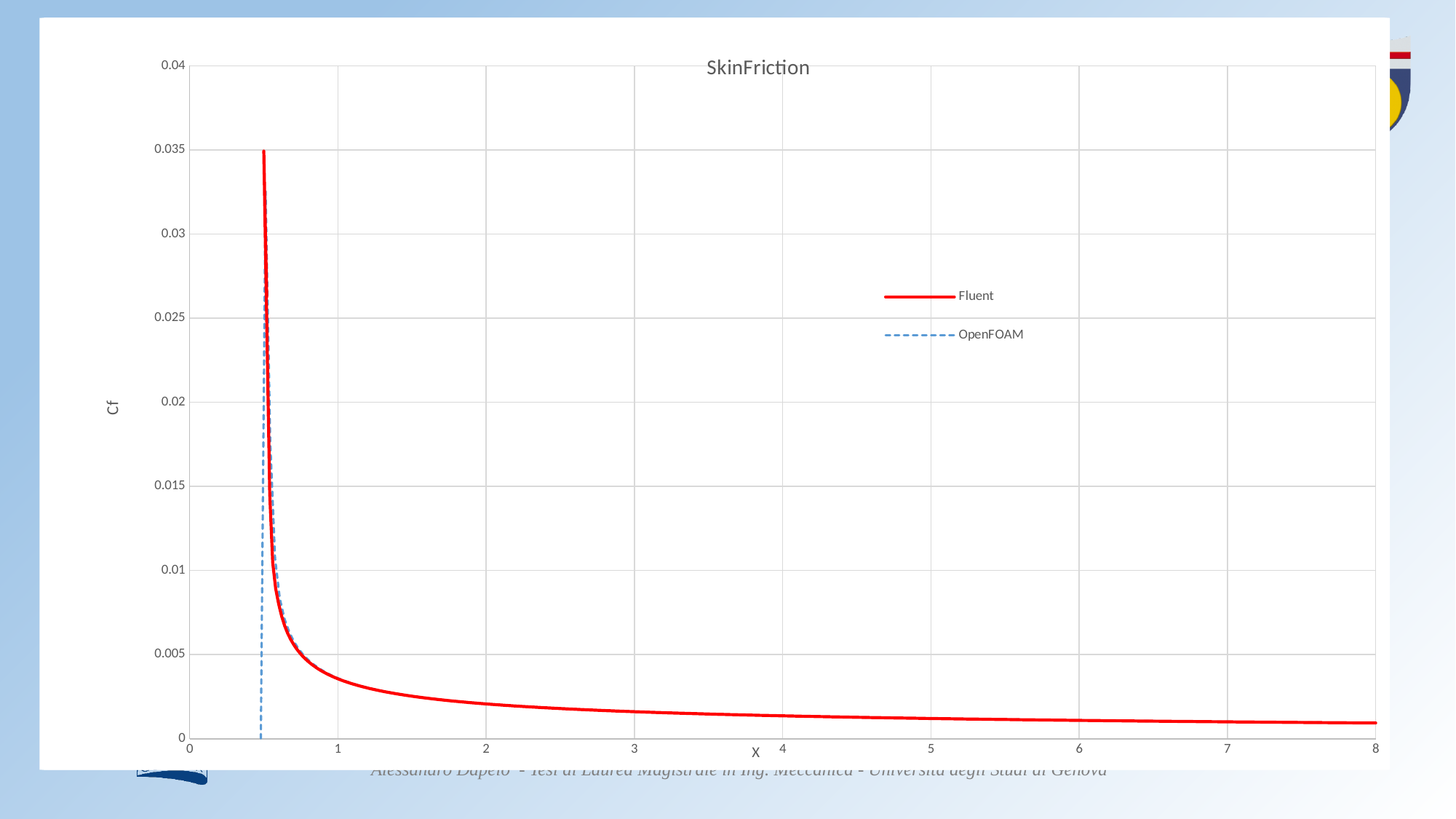
Is the Fluent value of Cf at x = 2 greater or less than 0.005? less Is the Fluent value of Cf at x = 8 greater or less than 0.005? less What is the title of the chart? SkinFriction What is the maximum value shown on the x axis? 8 How many series does the legend list? 2 Which series is drawn as a dashed line in the legend? OpenFOAM Do the Cf values of the Fluent series rise or fall as x increases from 1 to 8? fall Is the Fluent value of Cf at x = 1 greater or less than 0.01? less What kind of chart is shown on the slide? line chart